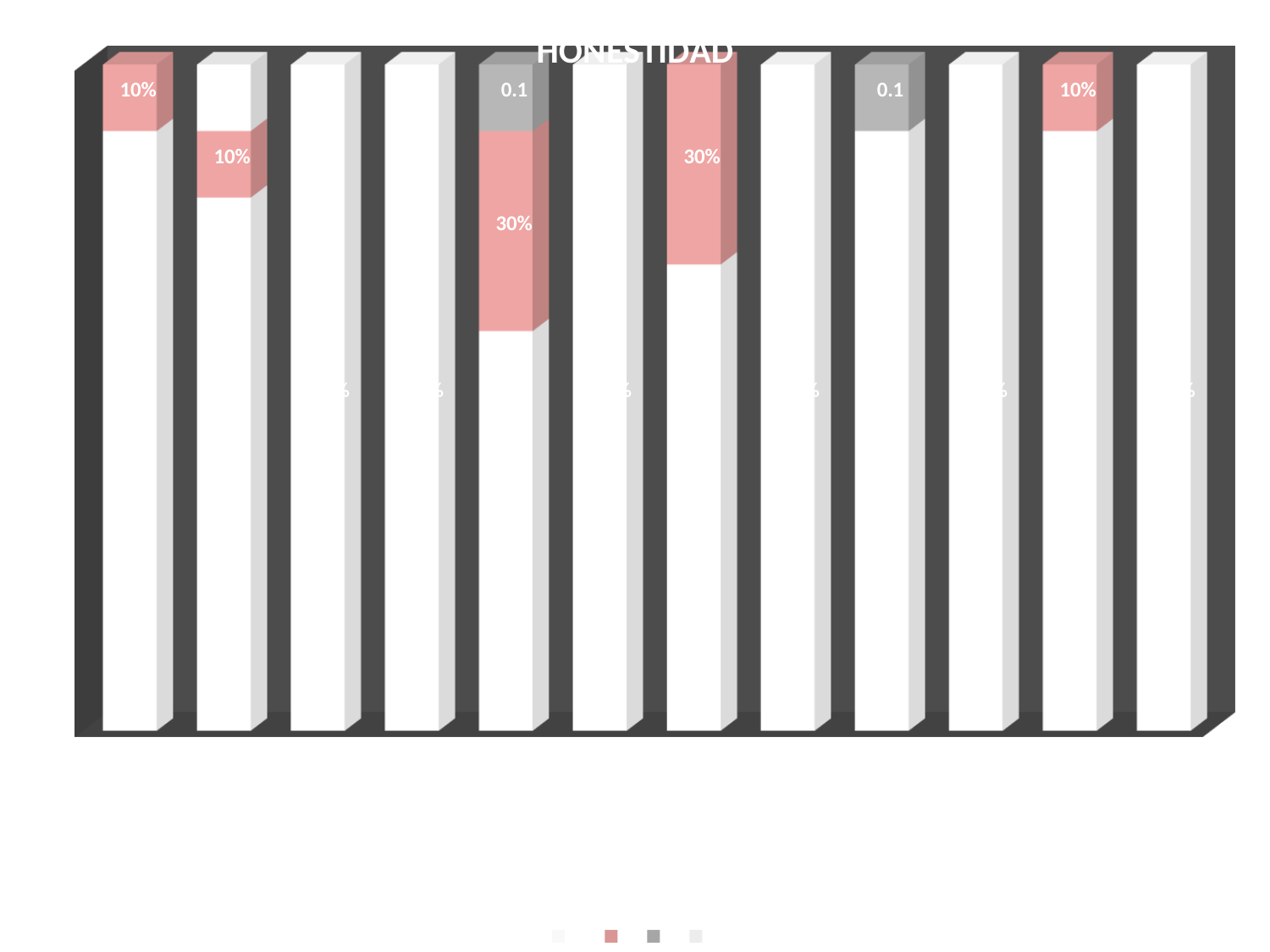
How many series does the legend list? 4 What value is labelled on the grey segment of the ninth bar from the left? 0.1 What is the title of the chart? HONESTIDAD Which has the larger pink segment: the first bar from the left or the fifth bar from the left? the fifth bar What kind of chart is shown on the slide? bar chart How many bars are plotted in the chart? 12 What value is labelled on the grey segment of the fifth bar from the left? 0.1 What value is labelled on the pink segment of the fifth bar from the left? 30% What value is labelled on the pink segment of the second bar from the left? 10% What value is labelled on the pink segment of the first bar from the left? 10% What is the difference between the pink segment of the seventh bar from the left and the pink segment of the eleventh bar from the left? 20% What value is labelled on the pink segment of the seventh bar from the left? 30%